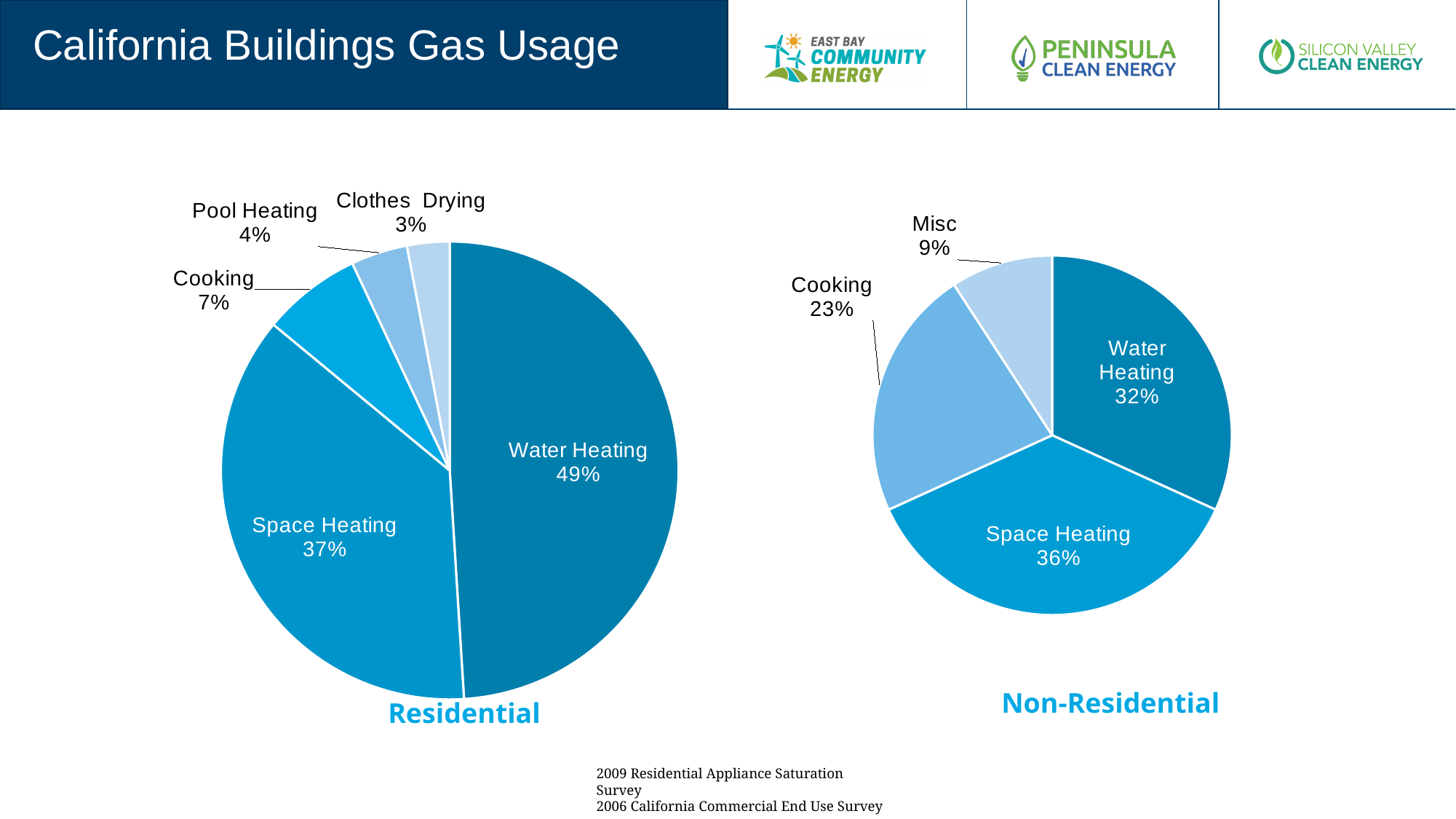
In the Residential chart, which category has the largest share? Water Heating In the Residential chart, what share of gas usage is Space Heating? 37% How many categories does the Residential chart show? 5 In the Residential chart, which category has the smallest share? Clothes Drying In the Non-Residential chart, what share of gas usage is Cooking? 23% In the Non-Residential chart, which category has the smallest share? Misc What type of chart is the Non-Residential chart? Pie chart In the Residential chart, which is larger, Pool Heating or Cooking? Cooking In the Residential chart, what share of gas usage is Water Heating? 49% In the Residential chart, what share of gas usage is Cooking? 7% In the Non-Residential chart, what is the difference between the Water Heating and Space Heating shares? 4% In the Non-Residential chart, what share of gas usage is Misc? 9%